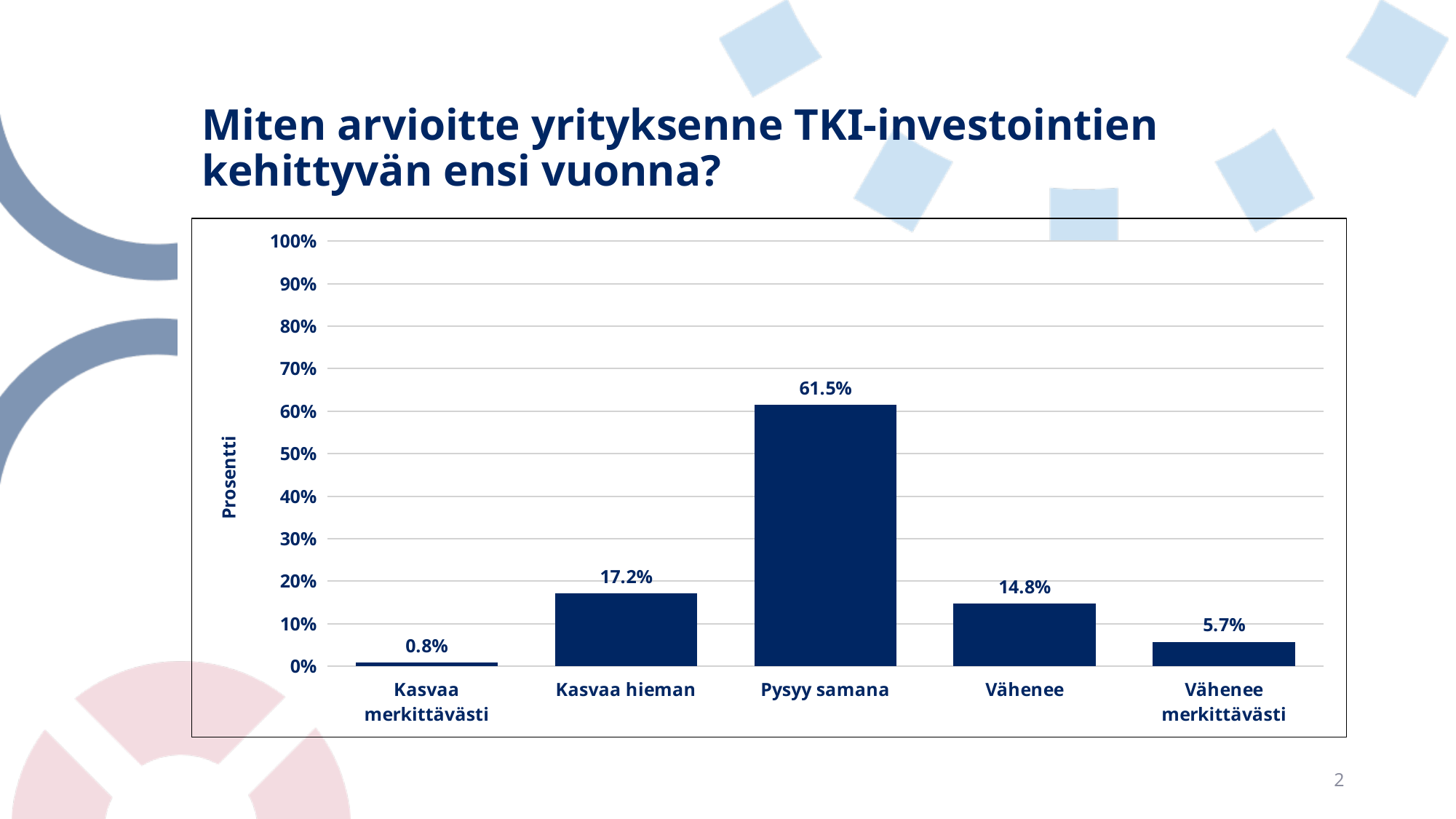
What is the value for Kasvaa hieman? 17.2% Which category has the highest value? Pysyy samana What is the difference between the values for Kasvaa hieman and Vähenee? 2.4% What is the value for Kasvaa merkittävästi? 0.8% What kind of chart is shown on the slide? bar chart Is the value for Pysyy samana greater or less than 50%? greater What is the label of the vertical axis? Prosentti What is the value for Pysyy samana? 61.5% How many categories are shown on the x axis? 5 Which category has the lowest value? Kasvaa merkittävästi What is the value for Vähenee merkittävästi? 5.7% Which is larger, the value for Vähenee or the value for Vähenee merkittävästi? Vähenee